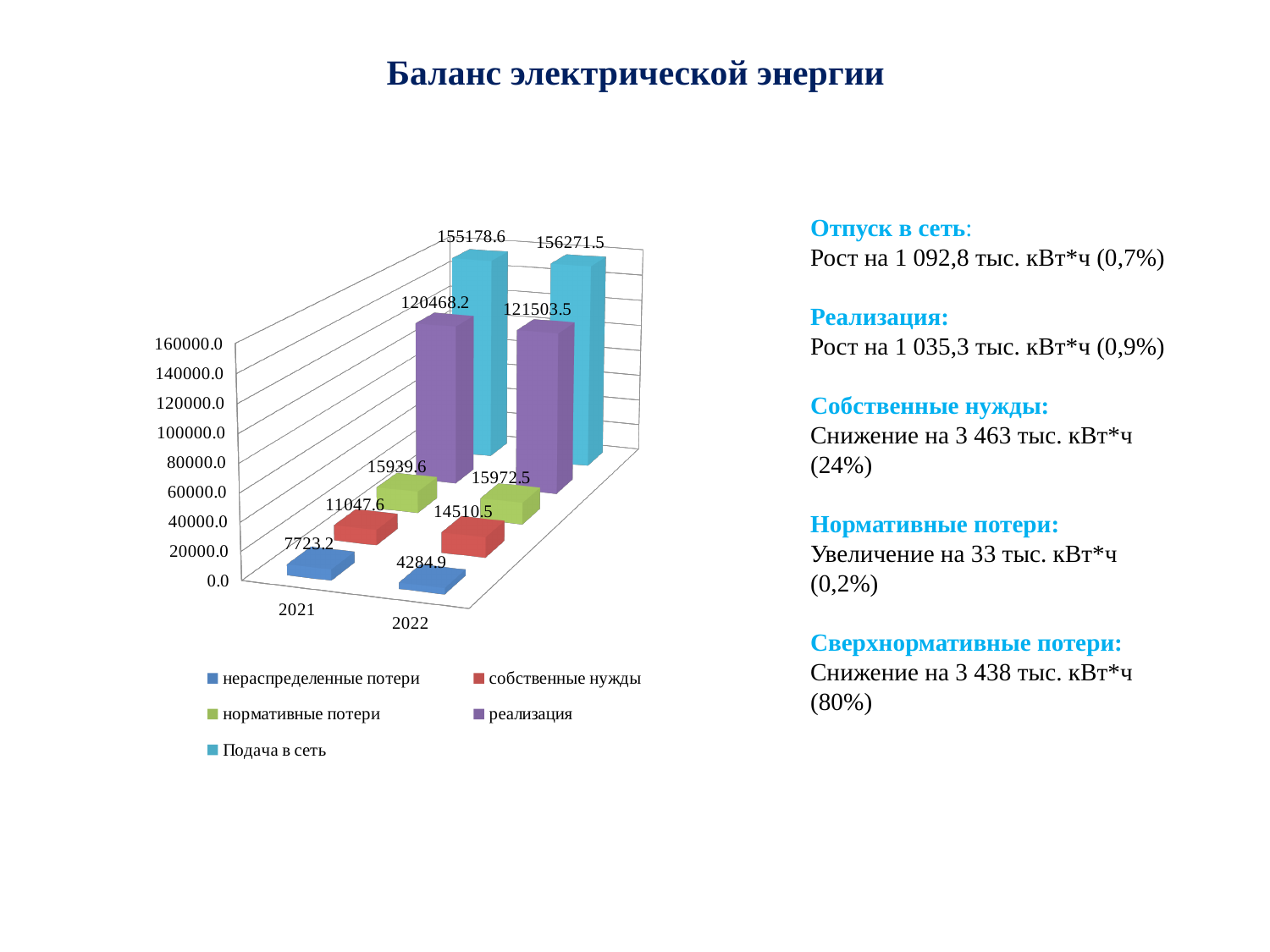
Which series has the lowest value in 2021? нераспределенные потери Which year has the larger value for нераспределенные потери, 2021 or 2022? 2021 What is the value of нераспределенные потери for 2022? 4284.9 What is the difference between the нормативные потери values for 2022 and 2021? 32.9 How many years (categories) are shown on the x axis? 2 What is the difference between the Подача в сеть values for 2022 and 2021? 1092.9 What is the value of Подача в сеть for 2021? 155178.6 How many series does the legend list? 5 What kind of chart is shown on the slide? bar chart Which series has the highest value in 2022? Подача в сеть What is the value of собственные нужды for 2021? 11047.6 What is the value of реализация for 2022? 121503.5